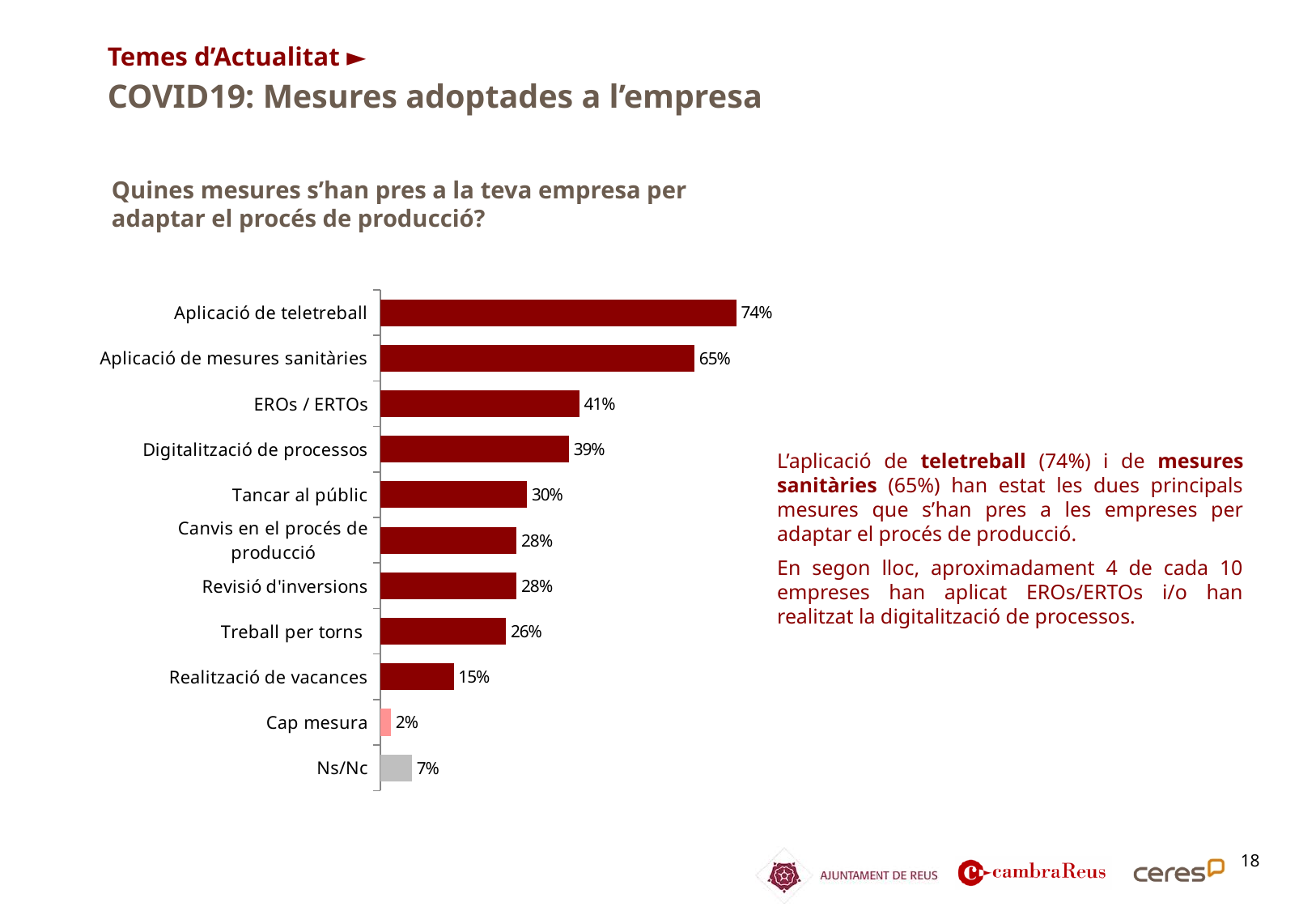
Which category's bar is shown in grey? Ns/Nc What is the value for Realització de vacances? 15% Which category has the lowest value? Cap mesura What is the difference between Aplicació de teletreball and Aplicació de mesures sanitàries? 9% What is the value for Ns/Nc? 7% What is the difference between Digitalització de processos and Tancar al públic? 9% What is the value for EROs / ERTOs? 41% What is the value for Aplicació de teletreball? 74% What kind of chart is shown on the slide? Bar chart Which category has the highest value? Aplicació de teletreball Which is larger, Treball per torns or Realització de vacances? Treball per torns How many categories are shown in the chart? 11